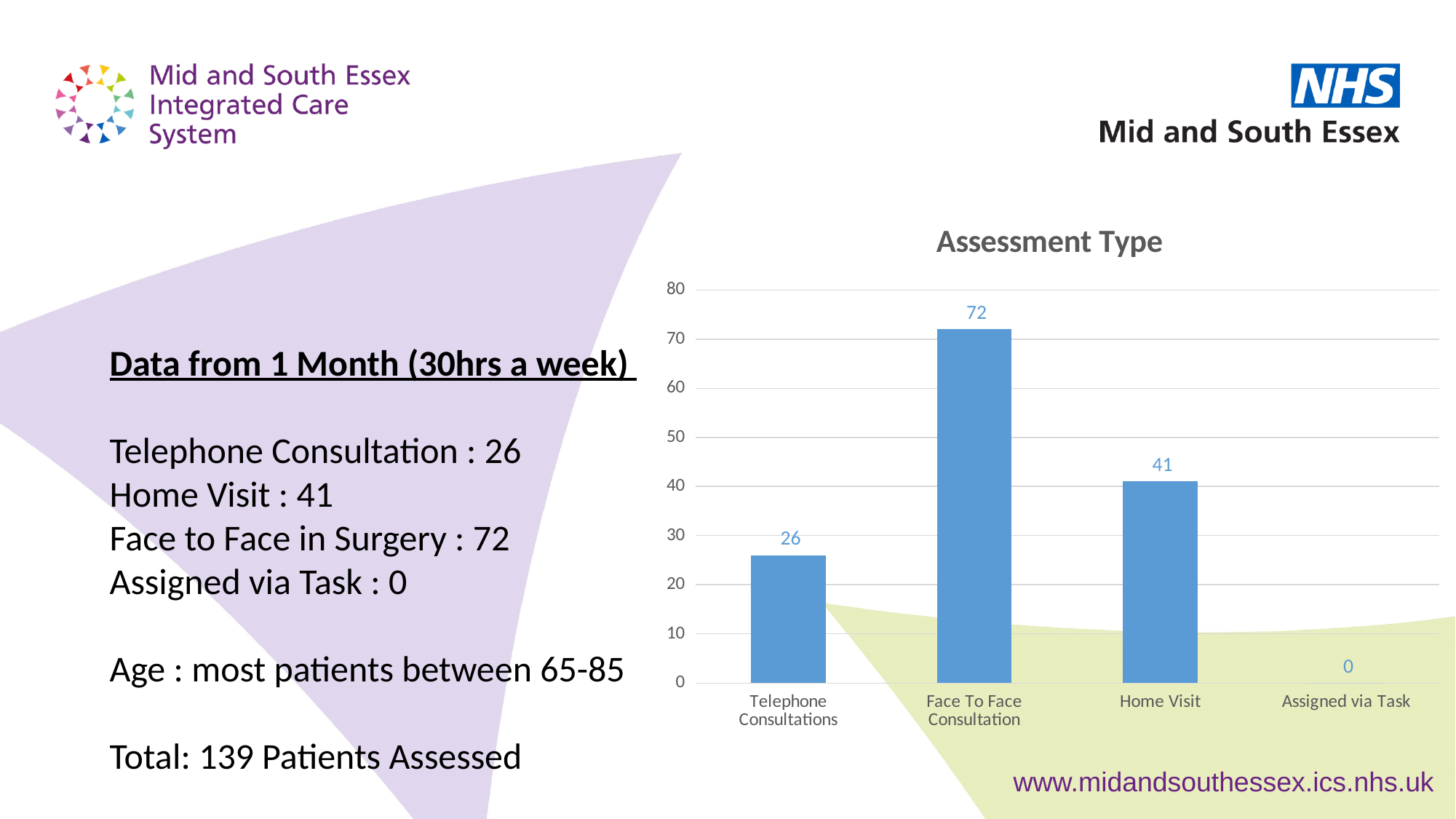
What is the difference between the Home Visit and Telephone Consultations values? 15 What is the value for Telephone Consultations in the Assessment Type chart? 26 What is the value for Face To Face Consultation in the Assessment Type chart? 72 What kind of chart is the Assessment Type chart? Bar chart What is the difference between the Face To Face Consultation and Home Visit values? 31 Which is larger, the value for Home Visit or the value for Telephone Consultations? Home Visit What is the value for Home Visit in the Assessment Type chart? 41 What is the value for Assigned via Task in the Assessment Type chart? 0 Which assessment type has the lowest value in the chart? Assigned via Task What is the title of the chart on the slide? Assessment Type Which assessment type has the highest value in the chart? Face To Face Consultation How many categories are shown on the x axis of the Assessment Type chart? 4